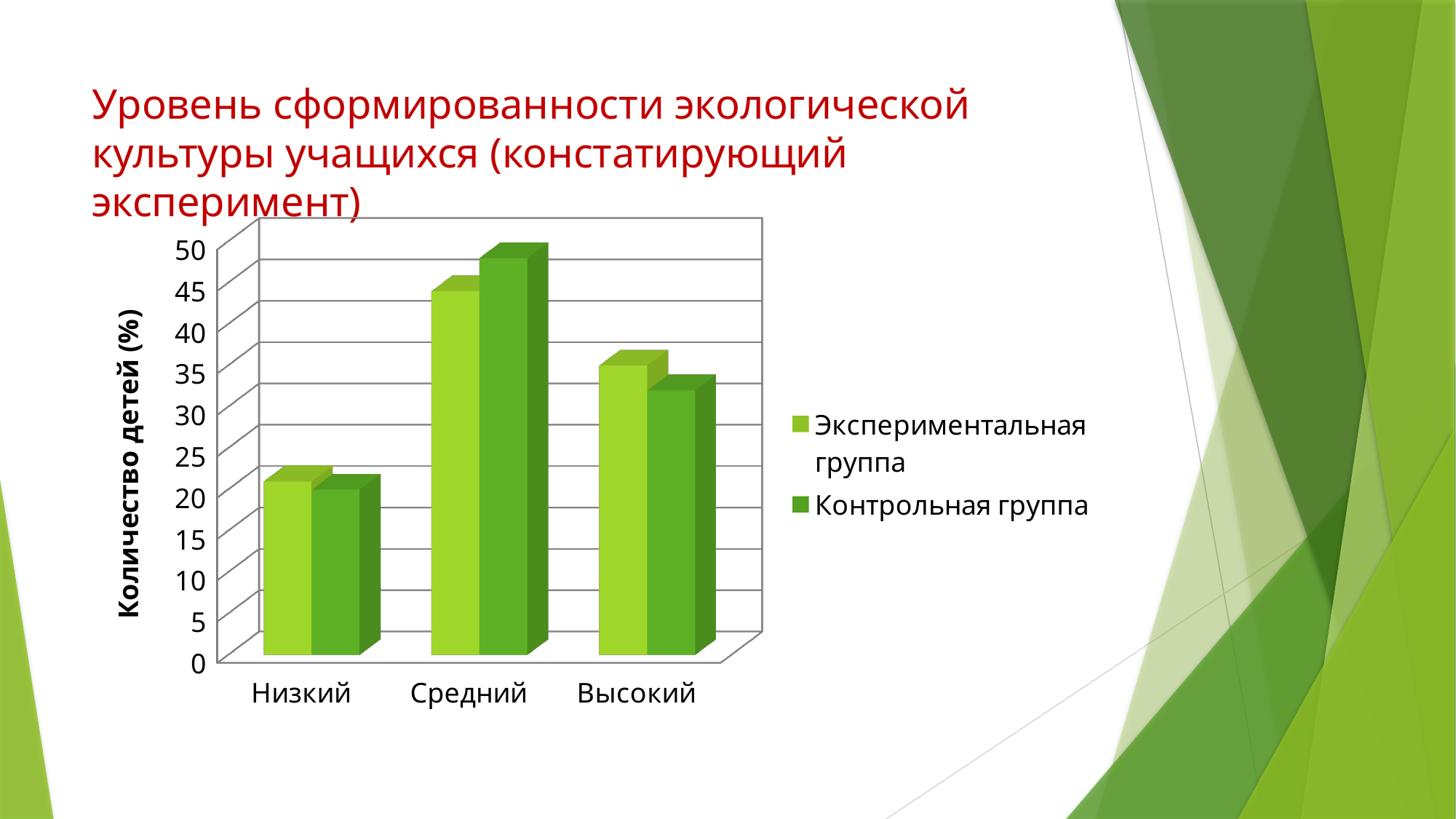
What kind of chart is shown on the slide? bar chart For the Высокий category, which series has the larger value: Экспериментальная группа or Контрольная группа? Экспериментальная группа Is the value for Контрольная группа in the Средний category greater or less than 45? greater Which category has the highest value for the Экспериментальная группа series? Средний For the Средний category, which series has the larger value: Экспериментальная группа or Контрольная группа? Контрольная группа What is the label of the vertical axis of the chart? Количество детей (%) Is the value for Экспериментальная группа in the Низкий category greater or less than 25? less Is the value for Экспериментальная группа in the Высокий category greater or less than 40? less How many series does the chart legend list? 2 What is the title of the slide containing the chart? Уровень сформированности экологической культуры учащихся (констатирующий эксперимент) Which category has the lowest value for the Контрольная группа series? Низкий How many categories are shown on the x axis of the chart? 3